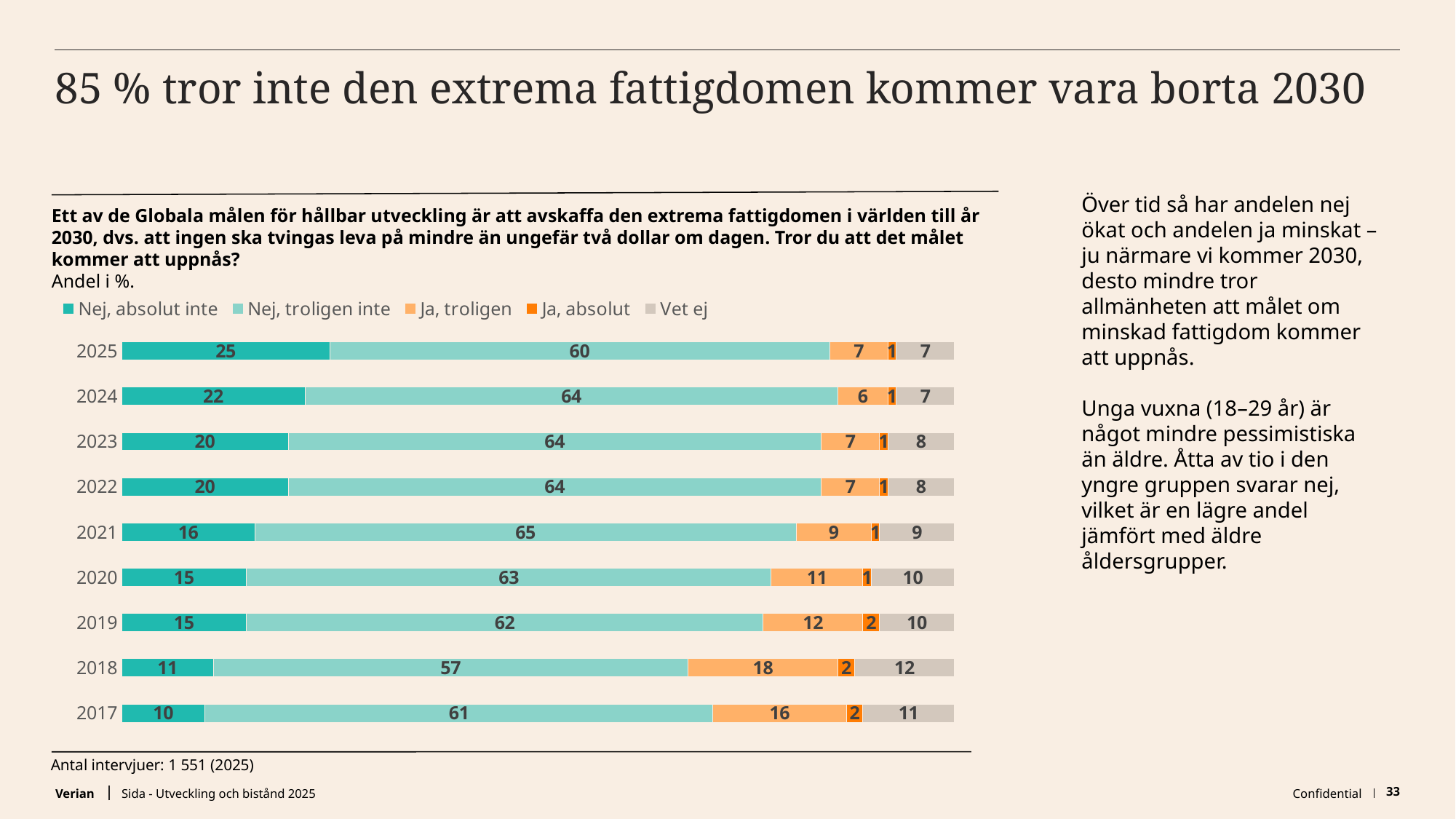
What is the value for "Nej, absolut inte" in 2025? 25 What kind of chart is shown on the slide? Stacked bar chart What is the value for "Vet ej" in 2020? 10 Which year has the highest value for "Nej, absolut inte"? 2025 What is the value for "Ja, troligen" in 2018? 18 What is the combined value of "Nej, absolut inte" and "Nej, troligen inte" for 2025? 85 Which year has the lowest value for "Nej, absolut inte"? 2017 How many series does the legend list? 5 Does the value for "Nej, absolut inte" rise or fall from 2017 to 2025? Rise How many years are shown in the chart? 9 What is the difference between the "Nej, troligen inte" values for 2021 and 2018? 8 Which year has the larger value for "Ja, troligen", 2019 or 2020? 2019